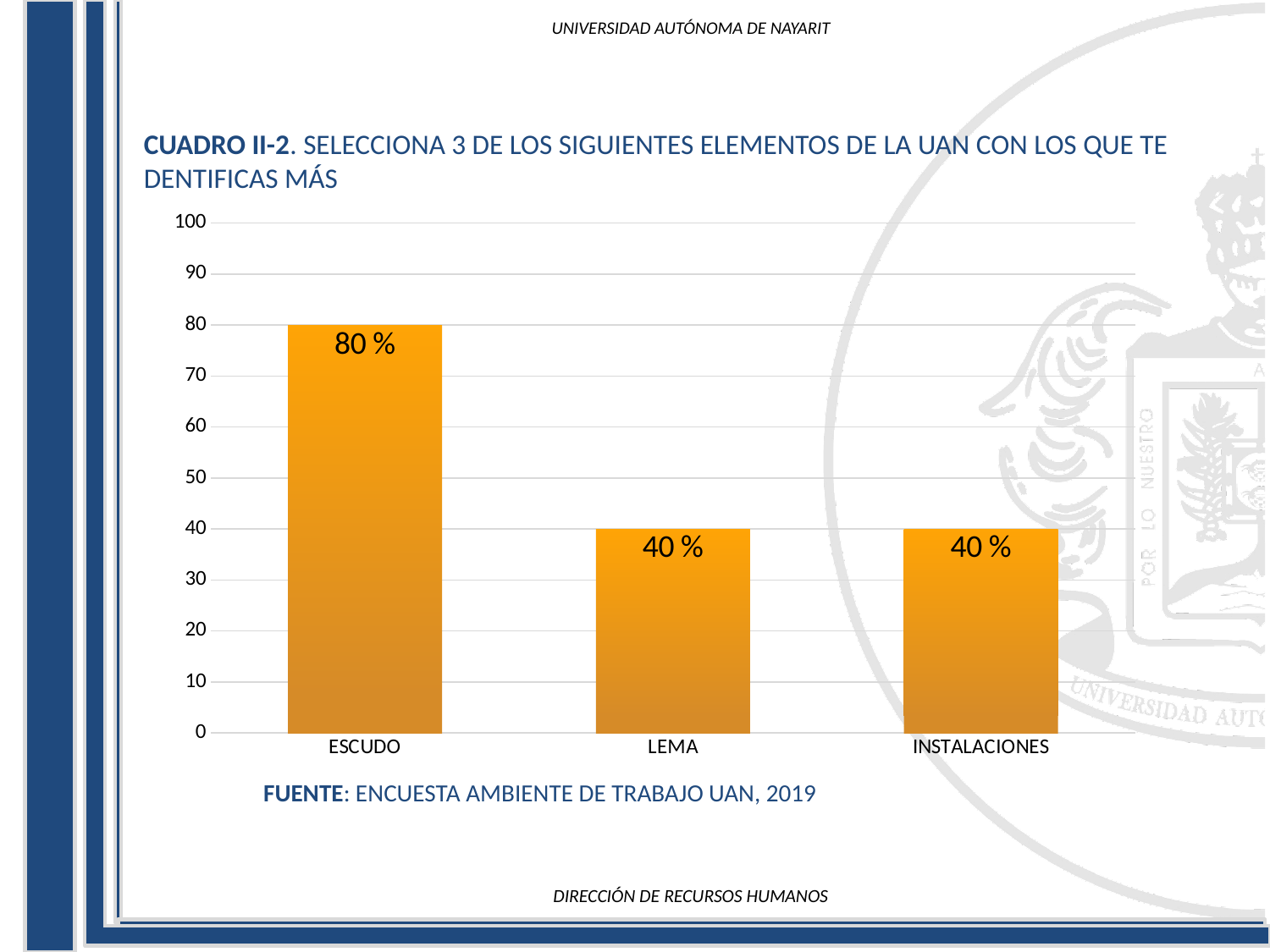
What is the value for LEMA? 40 % What kind of chart is shown on the slide? bar chart What is the difference between the values for ESCUDO and LEMA? 40 % What is the source cited below the chart? ENCUESTA AMBIENTE DE TRABAJO UAN, 2019 Is the value for LEMA greater or less than 50? less What is the value for ESCUDO? 80 % Is the value for ESCUDO greater or less than 70? greater How many categories are shown on the x axis? 3 Which category has the highest value? ESCUDO What is the maximum value shown on the y axis? 100 What is the value for INSTALACIONES? 40 % Which is larger, the value for ESCUDO or the value for INSTALACIONES? ESCUDO